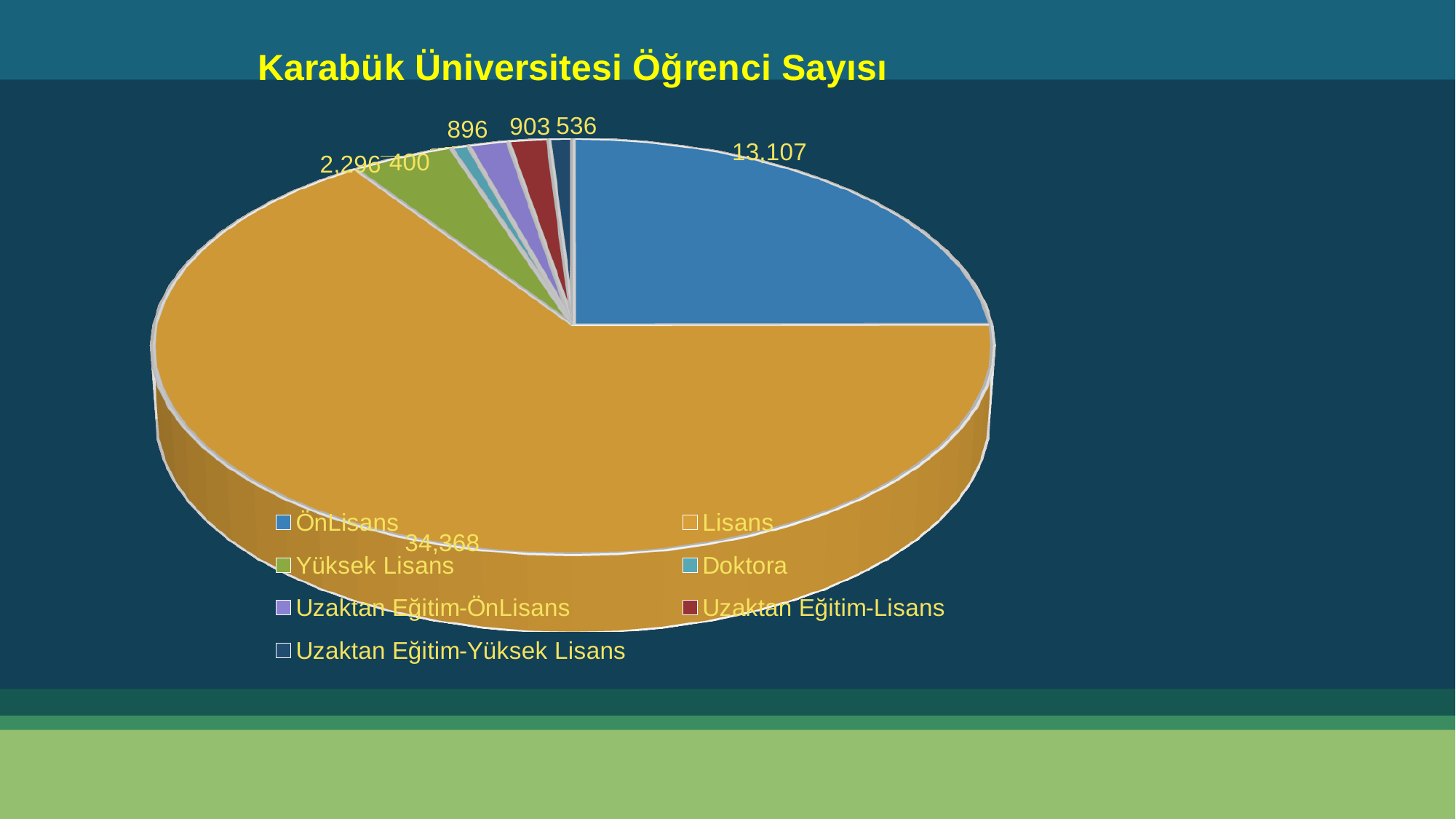
Which category has the largest slice? Lisans What is the difference between the values for Lisans and ÖnLisans? 21,261 Which category has the smallest slice? Doktora What is the value for Yüksek Lisans? 2,296 What is the value for Lisans? 34,368 What is the value for Doktora? 400 What type of chart is shown on the slide? Pie chart What colour is the Lisans slice? Orange What is the title of the chart? Karabük Üniversitesi Öğrenci Sayısı What is the value for ÖnLisans? 13,107 How many categories does the pie chart have? 7 Which is larger, the value for Yüksek Lisans or the value for Uzaktan Eğitim-Lisans? Yüksek Lisans